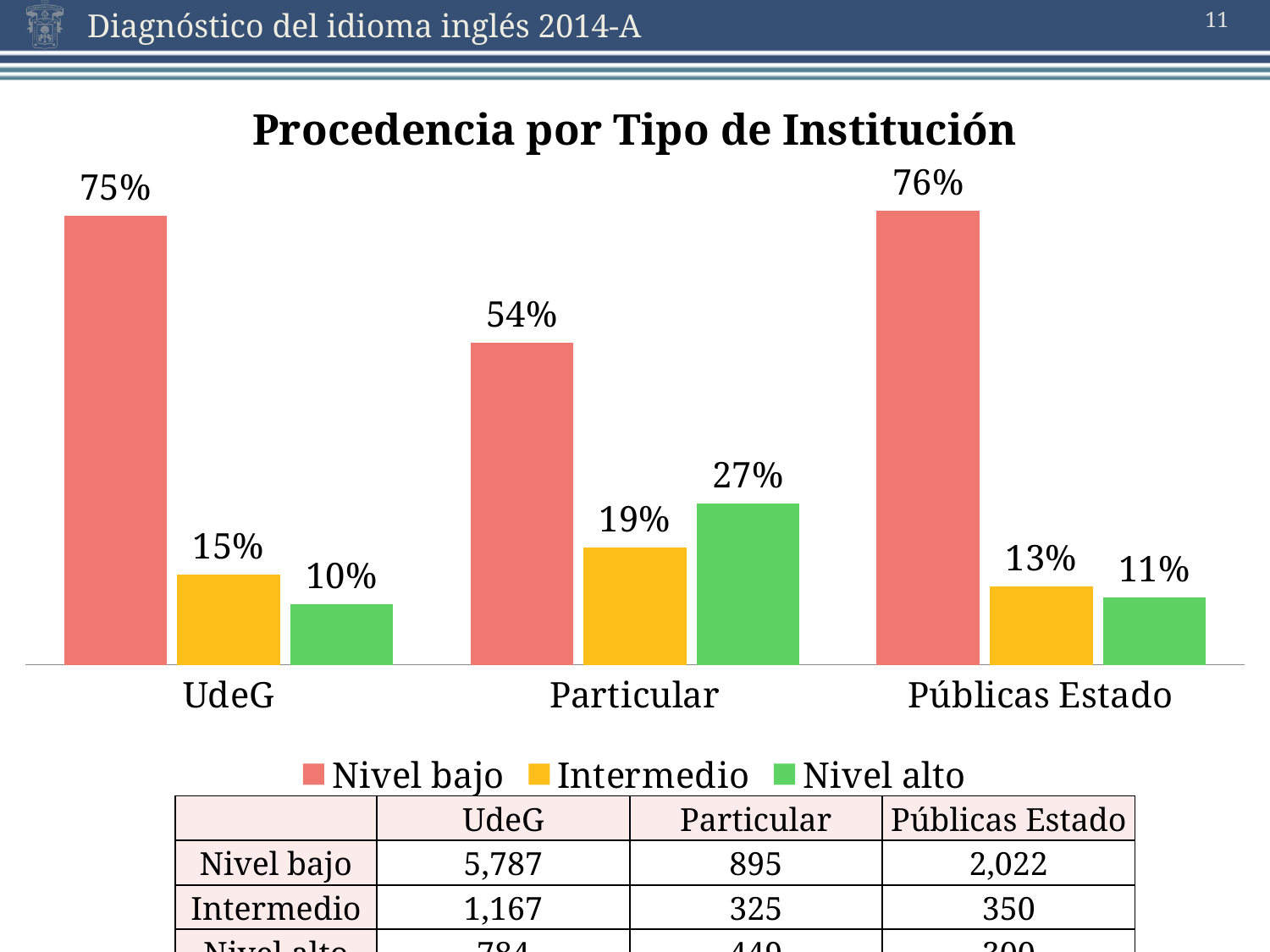
What is the value for Intermedio in the Públicas Estado category? 13% What kind of chart is shown? Bar chart How many categories are shown on the x axis? 3 Which category has the highest Nivel bajo value? Públicas Estado Which is larger, the Intermedio value for Particular or the Intermedio value for UdeG? Particular What is the value for Nivel alto in the Particular category? 27% What is the difference between the Nivel bajo values for UdeG and Particular? 21% What is the title of the chart? Procedencia por Tipo de Institución How many series does the legend list? 3 What is the value for Nivel bajo in the UdeG category? 75% Which colour represents the Nivel alto series? Green Which category has the lowest Nivel alto value? UdeG